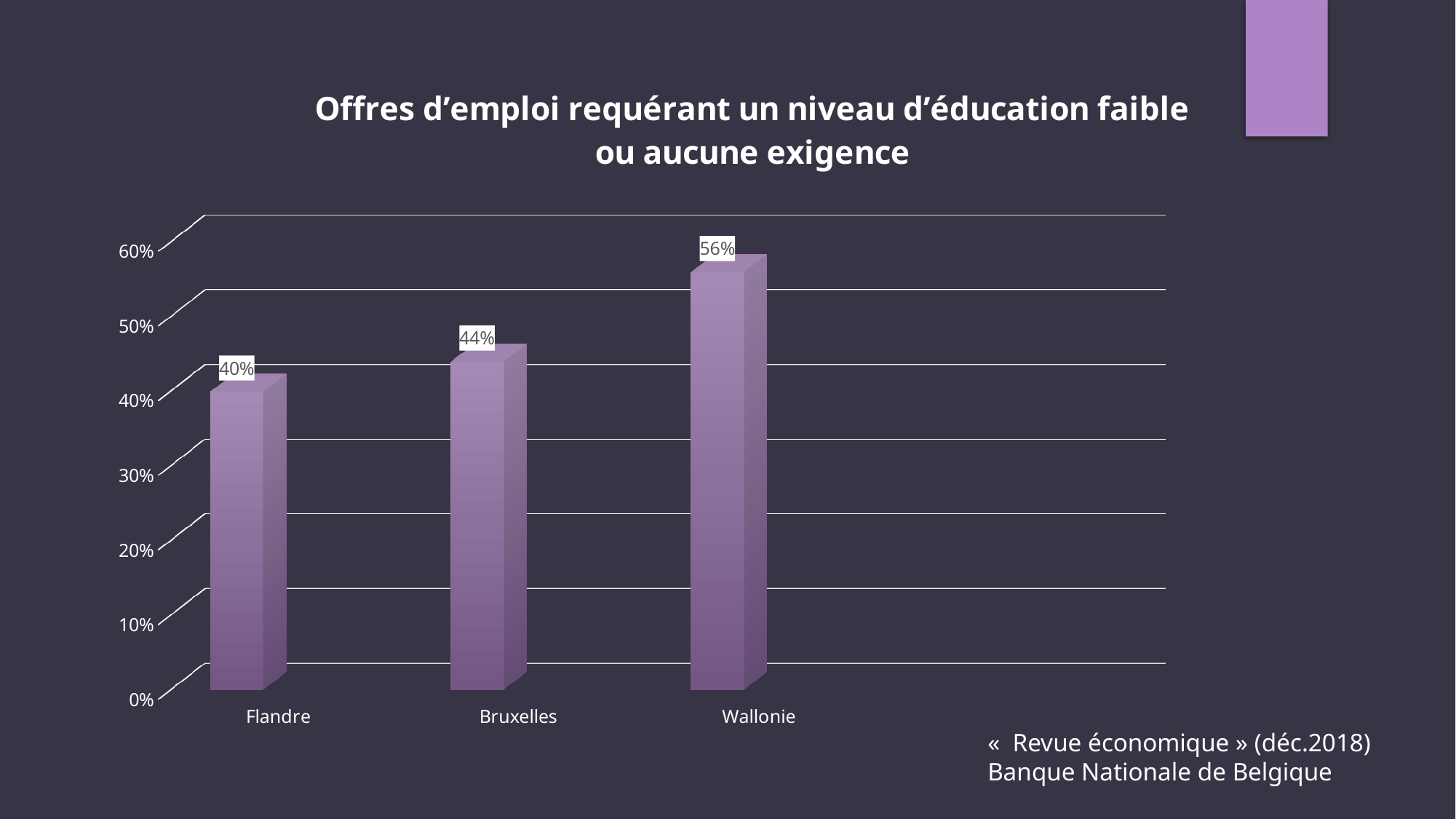
Is the value for Wallonie greater or less than 50%? greater What kind of chart is shown on the slide? bar chart What is the value for Wallonie? 56% What is the difference between the values for Bruxelles and Flandre? 4% What is the value for Flandre? 40% What is the title of the chart? Offres d’emploi requérant un niveau d’éducation faible ou aucune exigence What is the difference between the values for Wallonie and Flandre? 16% How many regions are shown on the chart? 3 Which region has the highest value? Wallonie Which region has the lowest value? Flandre Which is larger, the value for Bruxelles or the value for Wallonie? Wallonie What is the value for Bruxelles? 44%